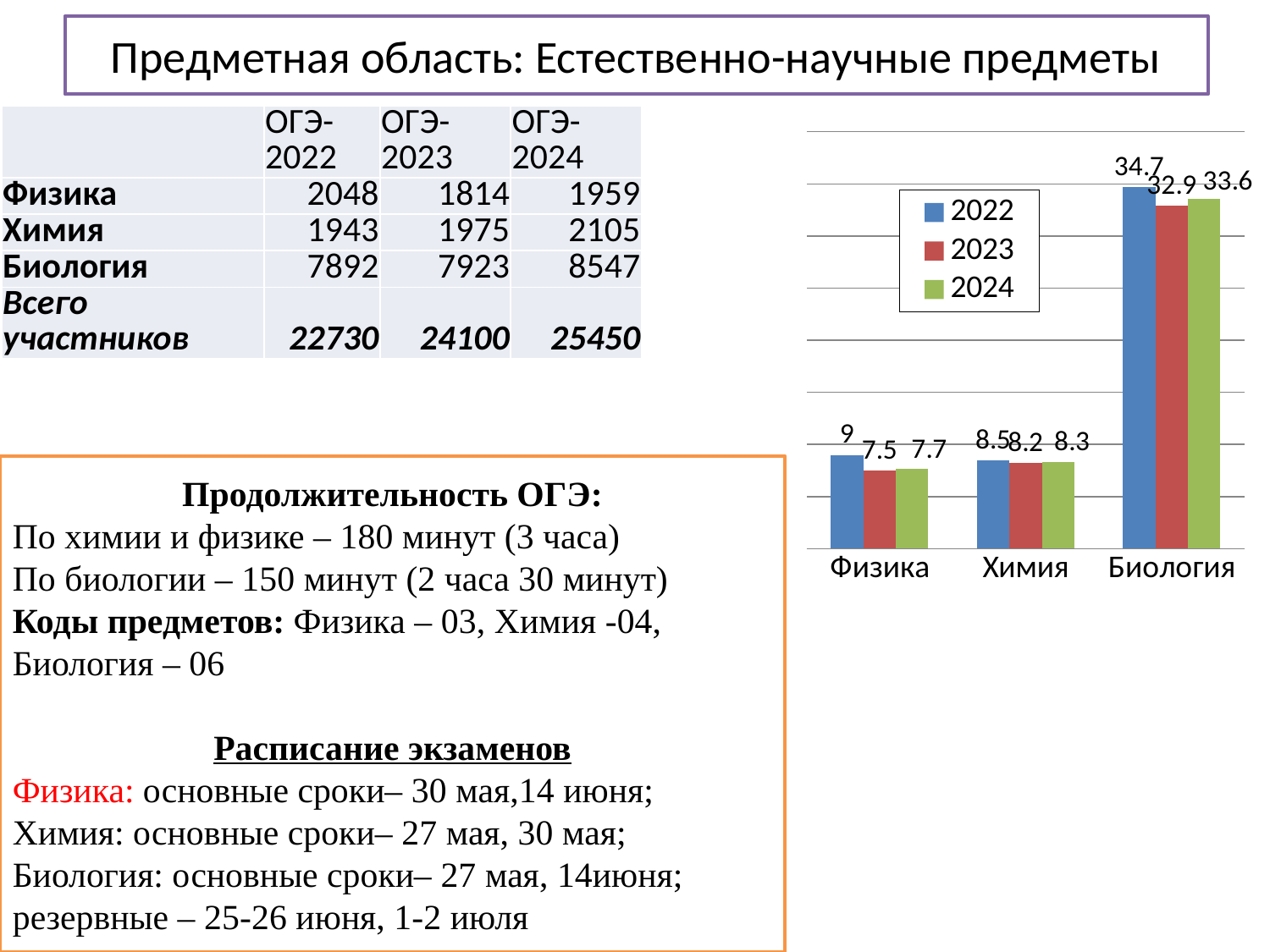
What is the value for Физика in 2022? 9 How many categories are shown on the x axis of the chart? 3 What is the difference between the 2022 and 2023 values for Биология? 1.8 Do the values for Физика rise or fall from 2022 to 2023? fall Which colour represents the 2024 series in the chart? green Which category has the lowest value in the 2024 series? Физика How many series does the chart legend list? 3 What is the value for Биология in 2024? 33.6 Which is larger for Физика: the 2022 value or the 2024 value? 2022 What is the value for Химия in 2023? 8.2 What kind of chart is shown on the slide? bar chart Which category has the highest value in the 2023 series? Биология